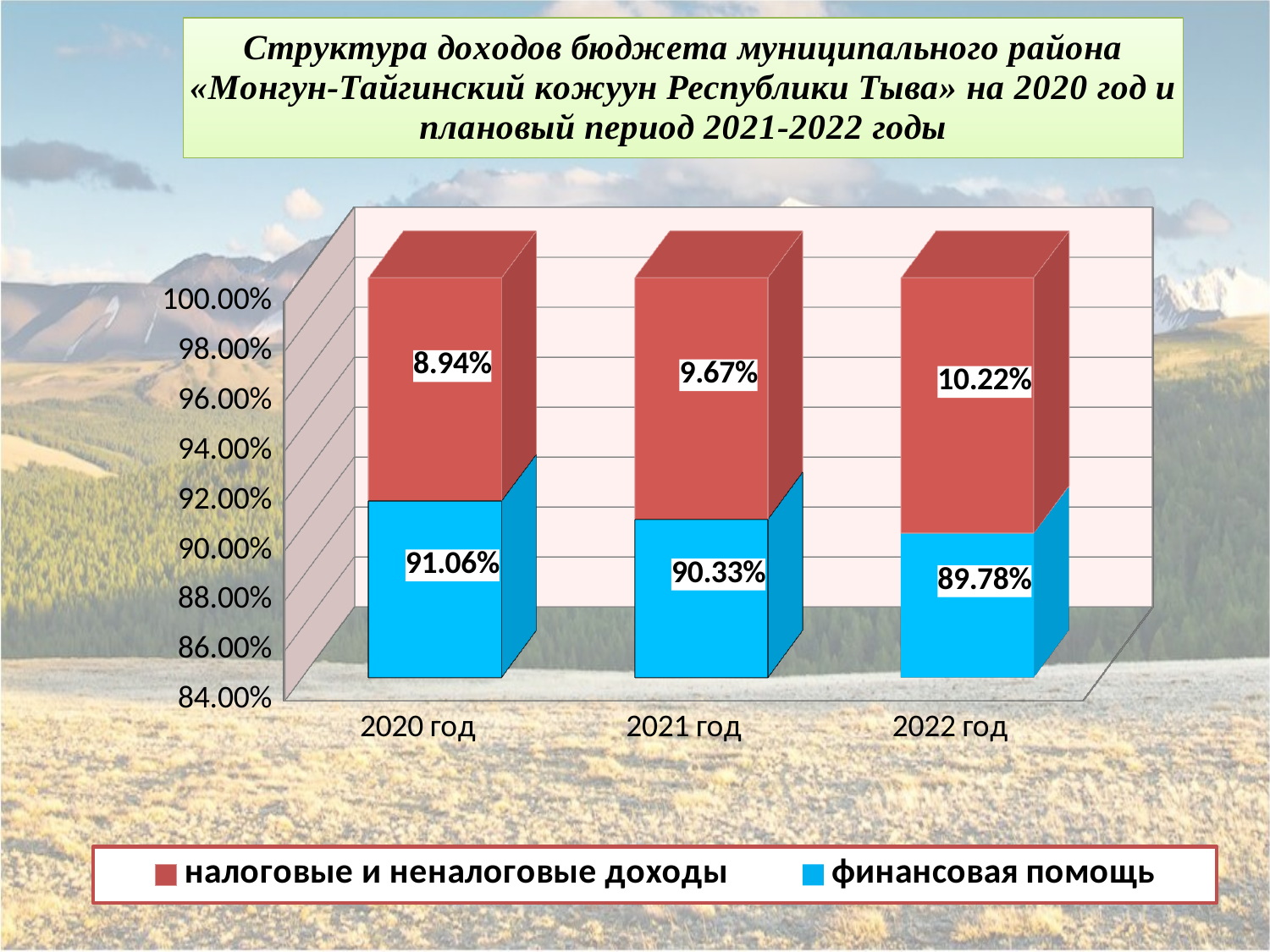
Which colour represents финансовая помощь in the legend? blue What is the value for налоговые и неналоговые доходы in 2022 год? 10.22% What is the difference between the налоговые и неналоговые доходы values for 2022 год and 2020 год? 1.28% What kind of chart is shown on the slide? stacked bar chart How many series does the legend list? 2 What is the value for финансовая помощь in 2021 год? 90.33% What is the value for налоговые и неналоговые доходы in 2020 год? 8.94% How many categories (years) are shown on the x axis? 3 In which year is the share of налоговые и неналоговые доходы highest? 2022 год Does the share of налоговые и неналоговые доходы rise or fall from 2020 год to 2022 год? rises What is the value for финансовая помощь in 2022 год? 89.78% In which year is the share of финансовая помощь lowest? 2022 год